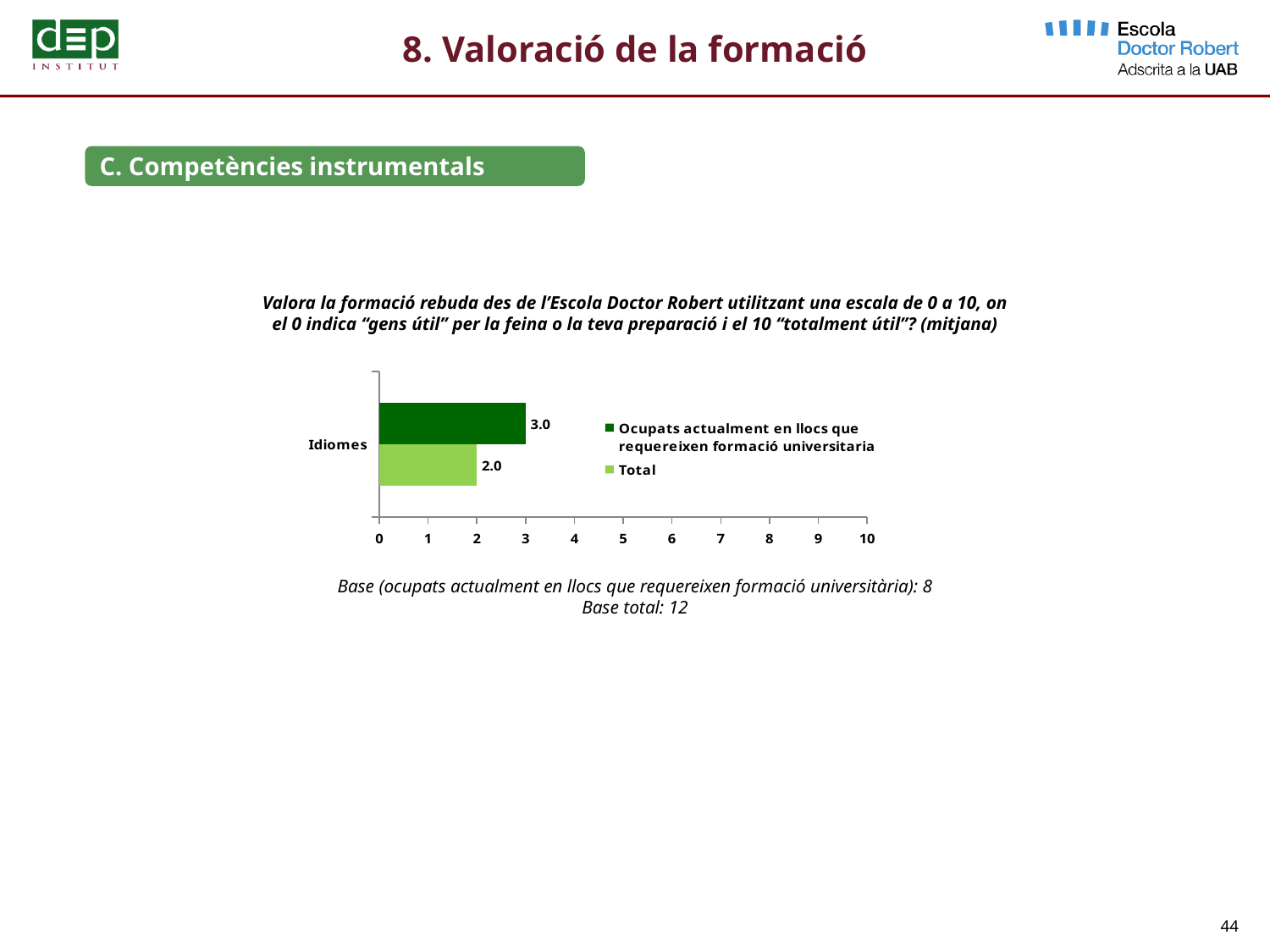
How many categories are shown on the chart? 1 Is the 'Total' value for Idiomes greater or less than 5? less How many series does the legend list? 2 What is the difference between the 'Ocupats actualment en llocs que requereixen formació universitaria' value and the 'Total' value for Idiomes? 1.0 Which series has the larger value for Idiomes: 'Ocupats actualment en llocs que requereixen formació universitaria' or 'Total'? Ocupats actualment en llocs que requereixen formació universitaria What kind of chart is shown on the slide? bar chart What is the value for Idiomes for the 'Total' series? 2.0 Which category is shown on the chart? Idiomes What is the maximum value shown on the x axis of the chart? 10 What is the value for Idiomes for the series 'Ocupats actualment en llocs que requereixen formació universitaria'? 3.0